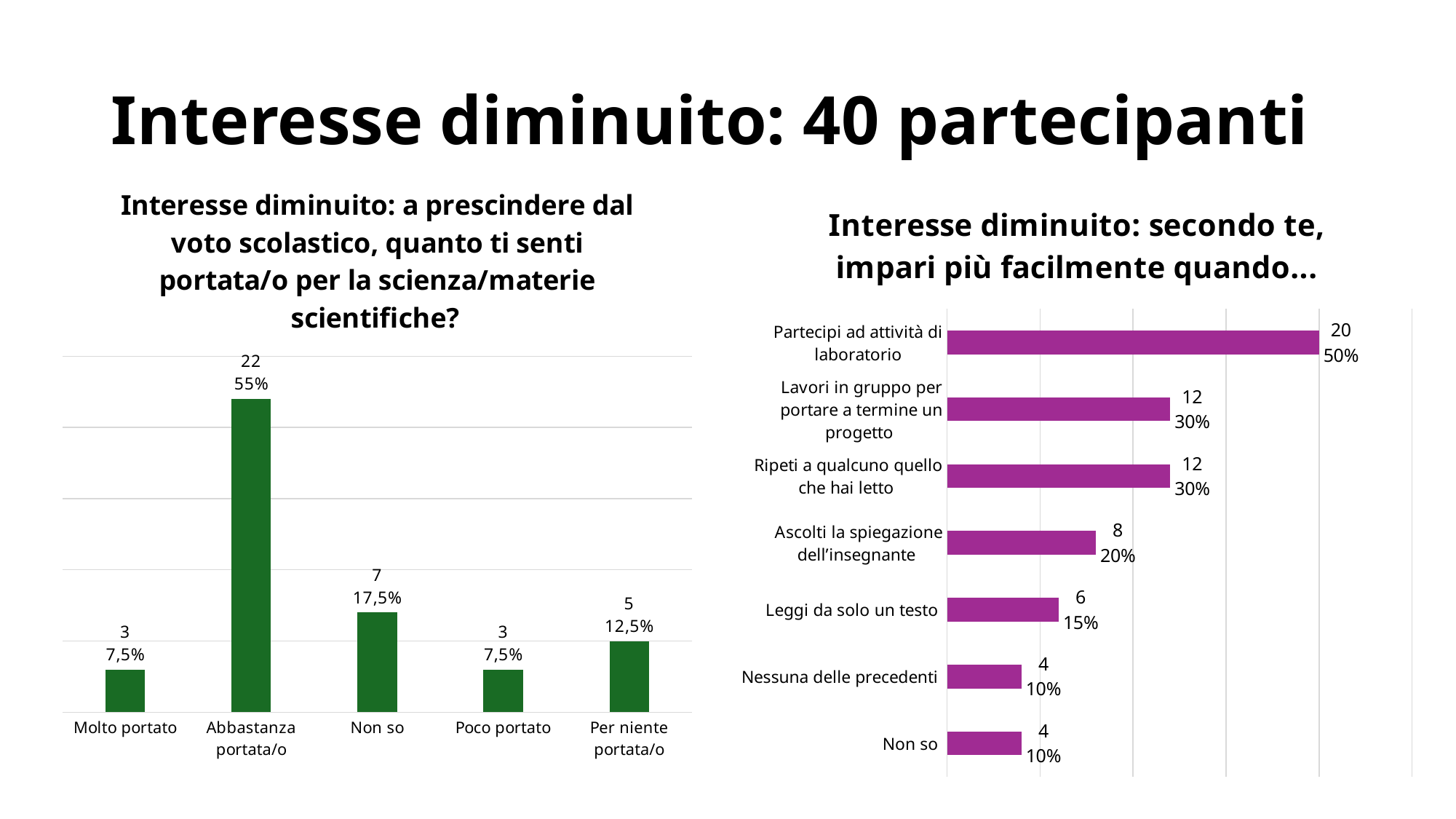
In the left chart (quanto ti senti portata/o per la scienza), which is larger: 'Per niente portata/o' or 'Poco portato'? Per niente portata/o In the right chart (impari più facilmente quando...), what is the difference between 'Partecipi ad attività di laboratorio' and 'Ascolti la spiegazione dell'insegnante'? 12 In the left chart (quanto ti senti portata/o per la scienza), how many respondents answered 'Abbastanza portata/o'? 22 In the right chart (impari più facilmente quando...), which category has the highest value? Partecipi ad attività di laboratorio In the right chart (impari più facilmente quando...), how many categories are listed? 7 In the right chart (impari più facilmente quando...), what percentage is shown for 'Leggi da solo un testo'? 15% In the right chart (impari più facilmente quando...), how many respondents chose 'Partecipi ad attività di laboratorio'? 20 In the left chart (quanto ti senti portata/o per la scienza), what is the difference between the values for 'Abbastanza portata/o' and 'Non so'? 15 What type of chart is the right chart (impari più facilmente quando...)? Bar chart In the left chart (quanto ti senti portata/o per la scienza), which category has the highest value? Abbastanza portata/o In the left chart (quanto ti senti portata/o per la scienza), how many categories are shown on the x axis? 5 In the left chart (quanto ti senti portata/o per la scienza), what percentage is shown for 'Non so'? 17,5%